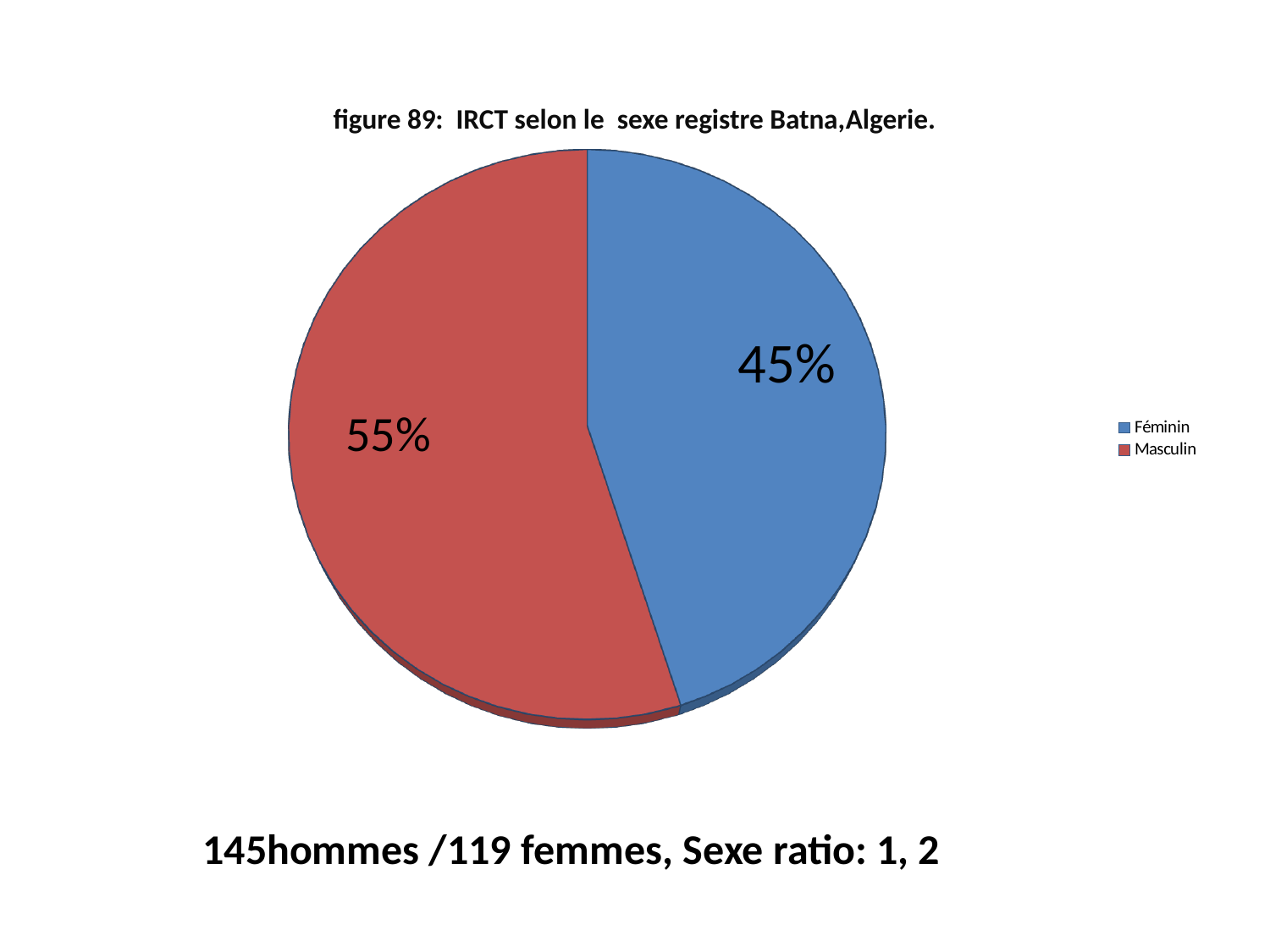
What is the title of the chart? figure 89: IRCT selon le sexe registre Batna,Algerie. Which slice is larger, Féminin or Masculin? Masculin How many entries does the legend list? 2 Which category has the largest slice of the pie? Masculin What share of the pie does the Féminin slice represent? 45% What colour is the Masculin slice? Red What is the difference in percentage points between the Masculin and Féminin slices? 10% Which category has the smallest slice of the pie? Féminin What kind of chart is shown on the slide? Pie chart How many slices does the pie chart have? 2 What share of the pie does the Masculin slice represent? 55%